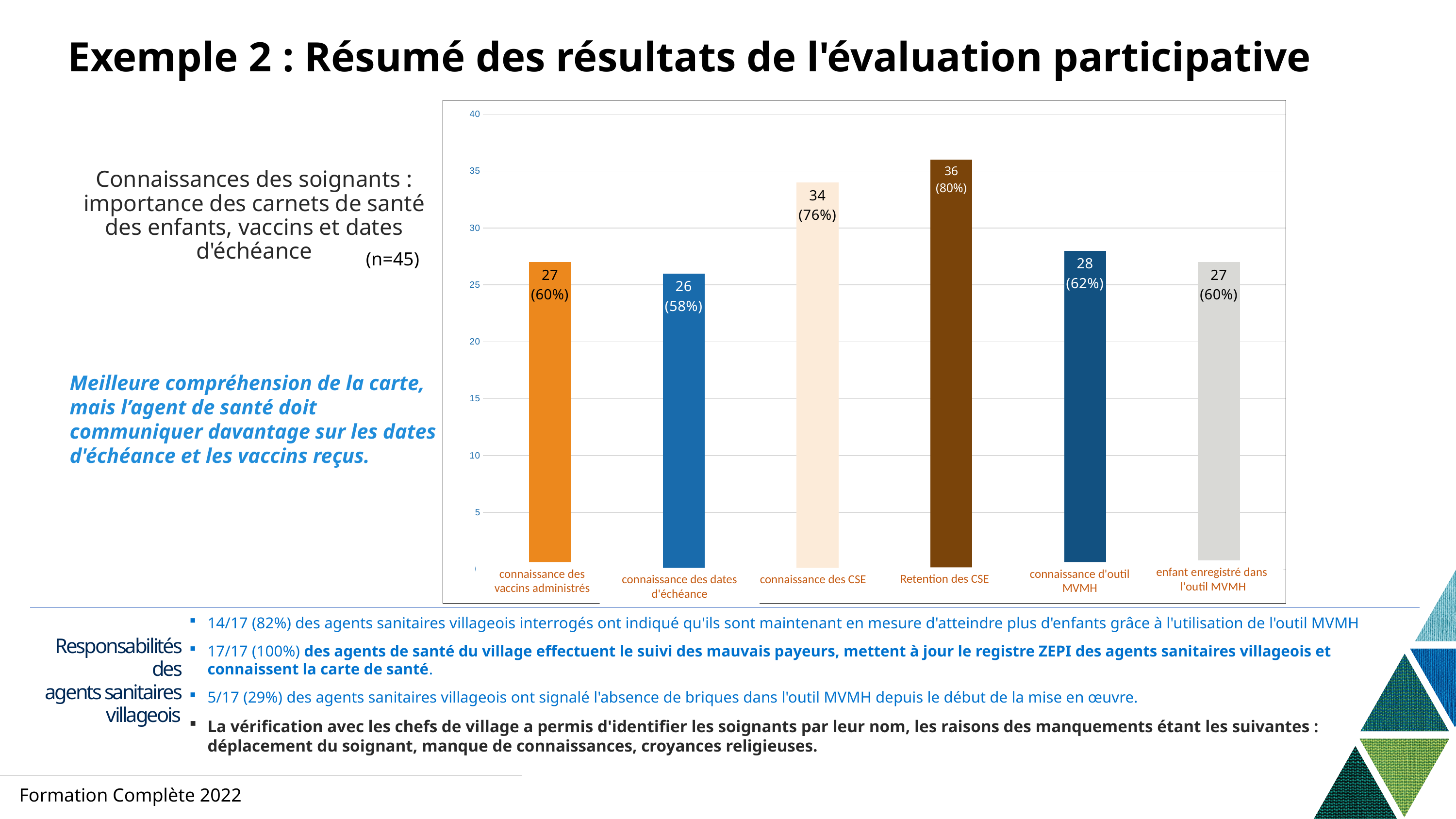
What is the difference between the values for 'Retention des CSE' and 'connaissance des dates d'échéance'? 10 What is the difference between the values for 'connaissance des CSE' and 'connaissance des vaccins administrés'? 7 What is the value for 'Retention des CSE'? 36 (80%) Which category has the lowest value? connaissance des dates d'échéance What percentage is shown for 'connaissance des dates d'échéance'? 58% What is the value for 'enfant enregistré dans l'outil MVMH'? 27 (60%) What kind of chart is shown on the slide? bar chart Which category has the highest value? Retention des CSE What is the value for 'connaissance d'outil MVMH'? 28 (62%) Which is larger: the value for 'connaissance des CSE' or for 'connaissance d'outil MVMH'? connaissance des CSE How many categories are shown in the chart? 6 Is the value for 'Retention des CSE' greater or less than 35? greater